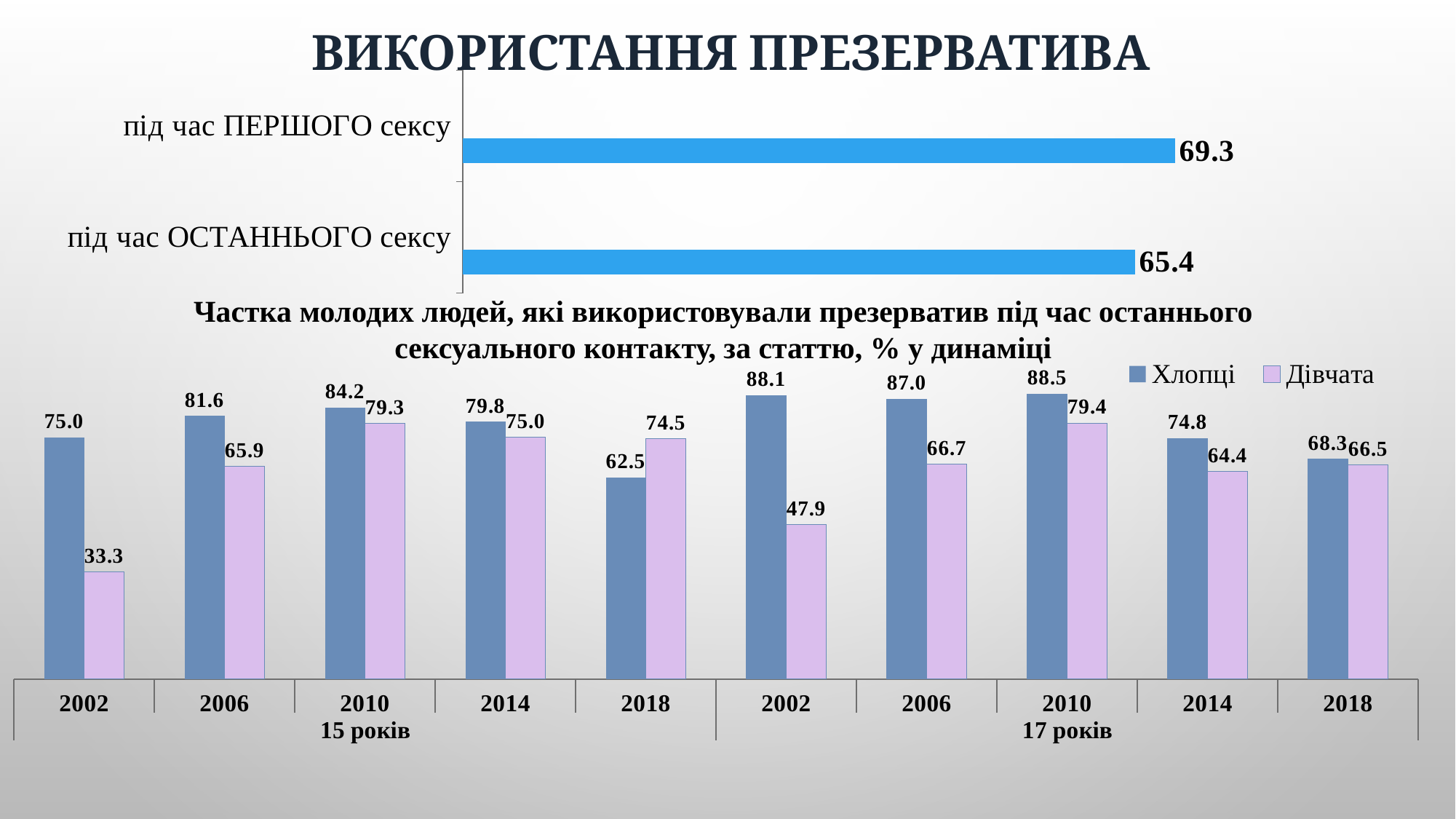
In the bottom chart, how many year categories are shown in total across both age groups? 10 In the top chart, what is the value for "під час ПЕРШОГО сексу"? 69.3 In the bottom chart, which category has the highest value for Хлопці? 2010, 17 років In the top chart, what is the value for "під час ОСТАННЬОГО сексу"? 65.4 In the bottom chart, which is larger in 2018 for 15 років: Хлопці or Дівчата? Дівчата In the bottom chart, what is the value for Хлопці in 2010 for 17 років? 88.5 What kind of chart is the top chart on the slide? Bar chart In the bottom chart, what is the difference between Хлопці and Дівчата in 2002 for 17 років? 40.2 In the top chart, what is the difference between the values for "під час ПЕРШОГО сексу" and "під час ОСТАННЬОГО сексу"? 3.9 In the bottom chart, which category has the lowest value for Дівчата? 2002, 15 років In the bottom chart, what is the value for Дівчата in 2002 for 15 років? 33.3 How many series does the legend of the bottom chart list? 2